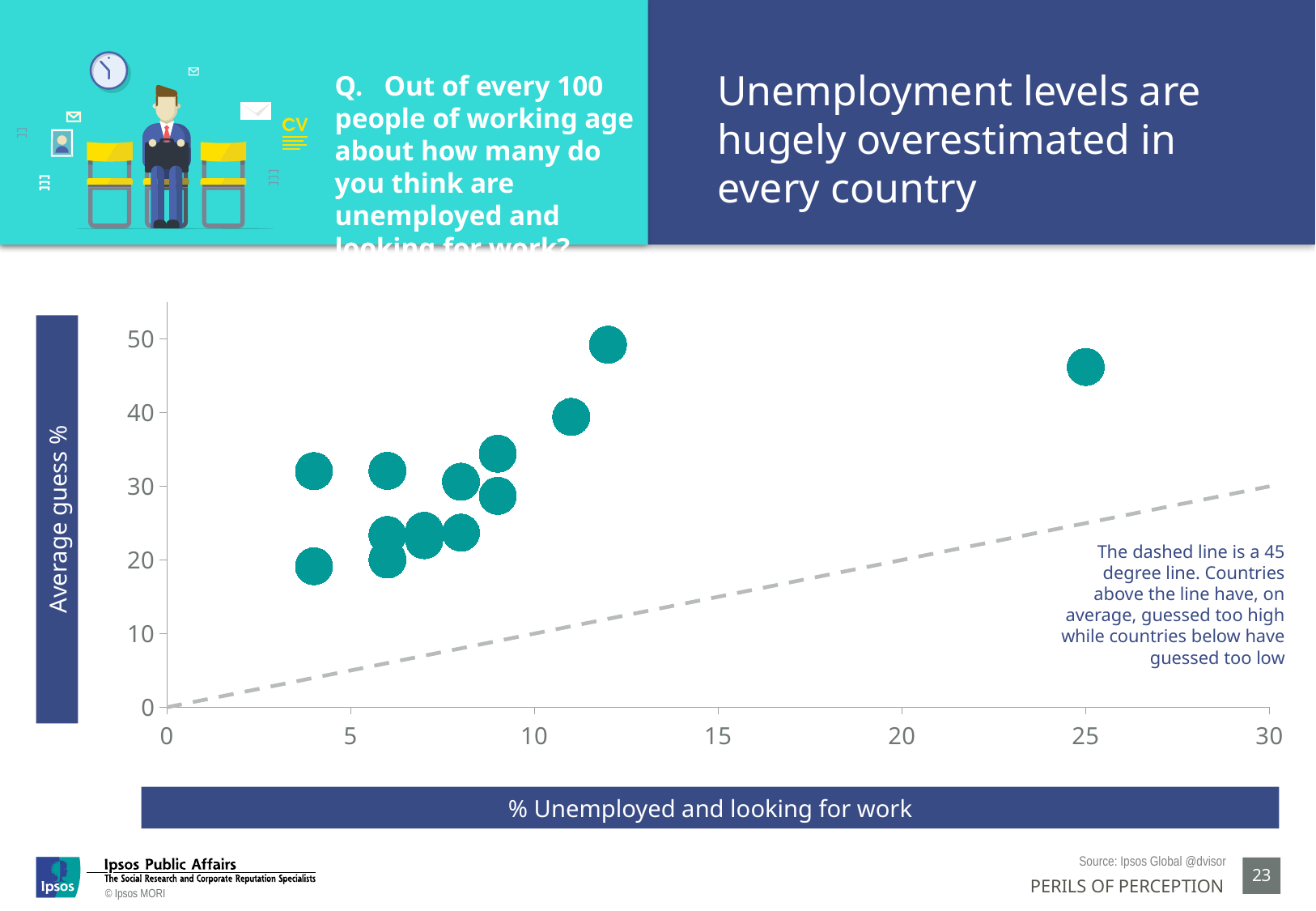
What is the label of the vertical axis of the chart? Average guess % Is the average guess for the lowest plotted point greater or less than 10? greater Do the plotted points lie above or below the dashed 45 degree line? above What is the title of the chart on the slide? Unemployment levels are hugely overestimated in every country What is the highest value shown on the horizontal axis of the chart? 30 What kind of chart is shown on the slide? scatter chart Is the average guess for the highest plotted point greater or less than 40? greater Is the actual unemployment rate for the rightmost plotted point greater or less than 20? greater Do the average guess values generally rise or fall as the actual unemployment rate increases along the x axis? rise